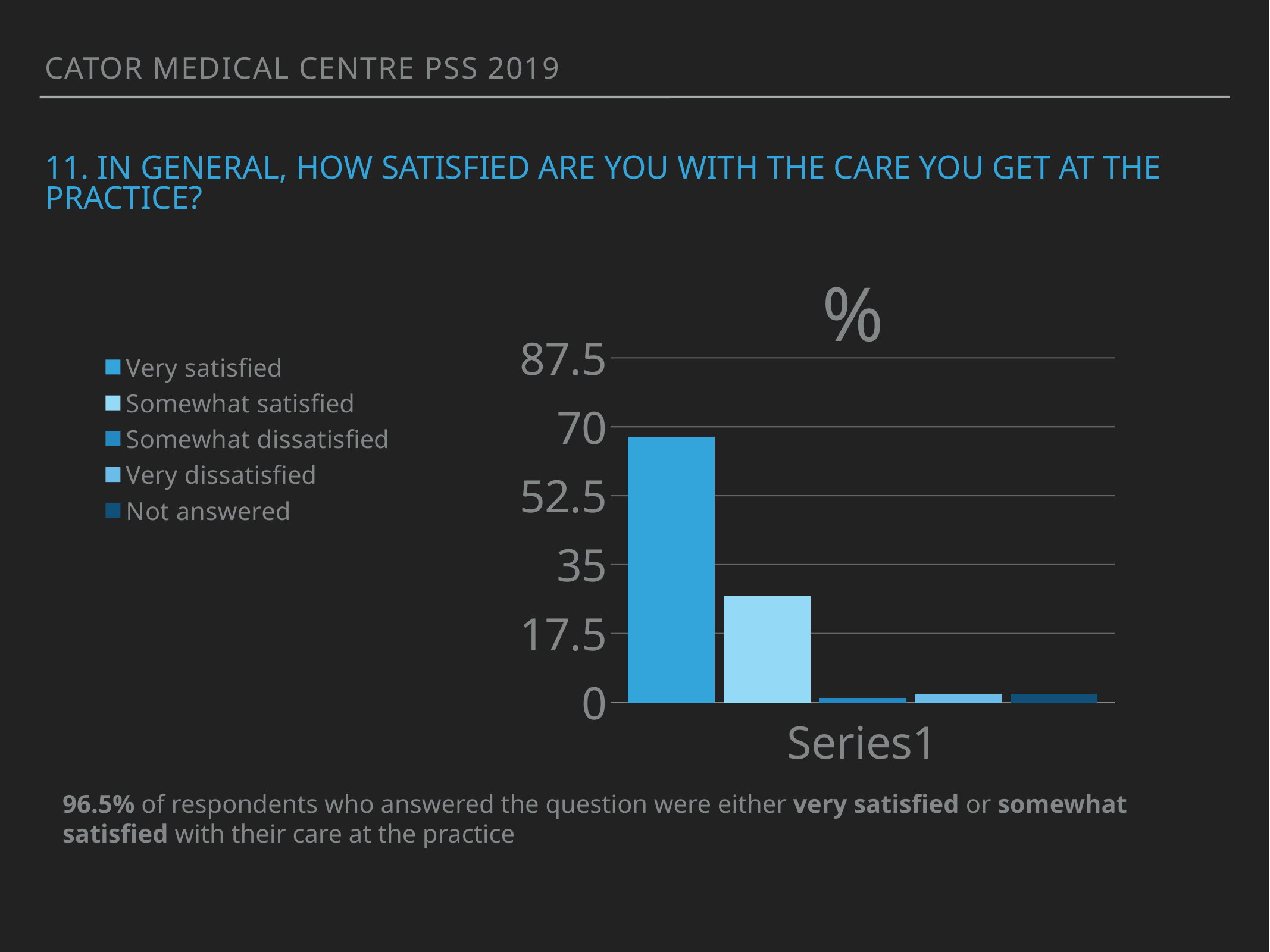
Which series has the tallest bar in the chart? Very satisfied What is the title of the chart? % Is the value for Not answered greater or less than 17.5? less What kind of chart is shown on the slide? bar chart Is the value for Very satisfied greater or less than 52.5? greater What is the label shown on the x axis of the chart? Series1 Which is larger, the value for Somewhat satisfied or the value for Very dissatisfied? Somewhat satisfied Is the value for Somewhat satisfied greater or less than 35? less Which is larger, the value for Very satisfied or the value for Somewhat satisfied? Very satisfied How many series does the chart legend list? 5